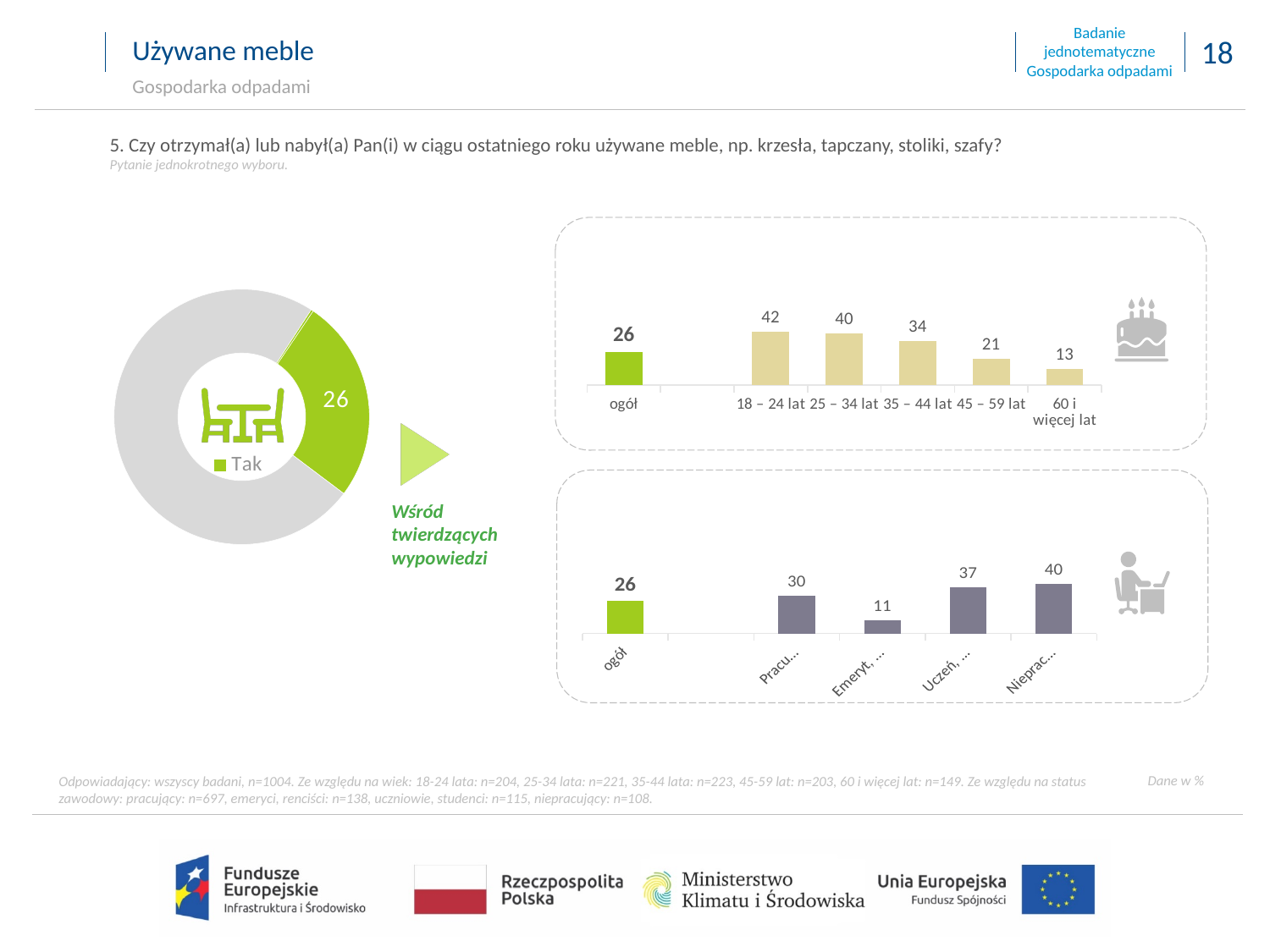
In the bottom-right bar chart by occupational status, which category has the highest value? Nieprac… In the top-right bar chart by age, how many age-group bars are shown (excluding ogół)? 5 In the top-right bar chart by age, which age group has the lowest value? 60 i więcej lat In the top-right bar chart by age, what is the value for 18 – 24 lat? 42 What type of chart is the chart on the left of the slide? donut (pie) chart In the top-right bar chart by age, what is the value for 60 i więcej lat? 13 In the bottom-right bar chart by occupational status, what is the value for the bar labelled Emeryt, …? 11 In the top-right bar chart by age, do the values rise or fall from 18 – 24 lat to 60 i więcej lat? fall In the top-right bar chart by age, which age group has the highest value? 18 – 24 lat In the donut chart on the left, what value is shown for Tak? 26 In the top-right bar chart by age, what is the difference between the values for 25 – 34 lat and 45 – 59 lat? 19 In the bottom-right bar chart by occupational status, which is larger: the value for Pracu… or the value for Uczeń, …? Uczeń, …